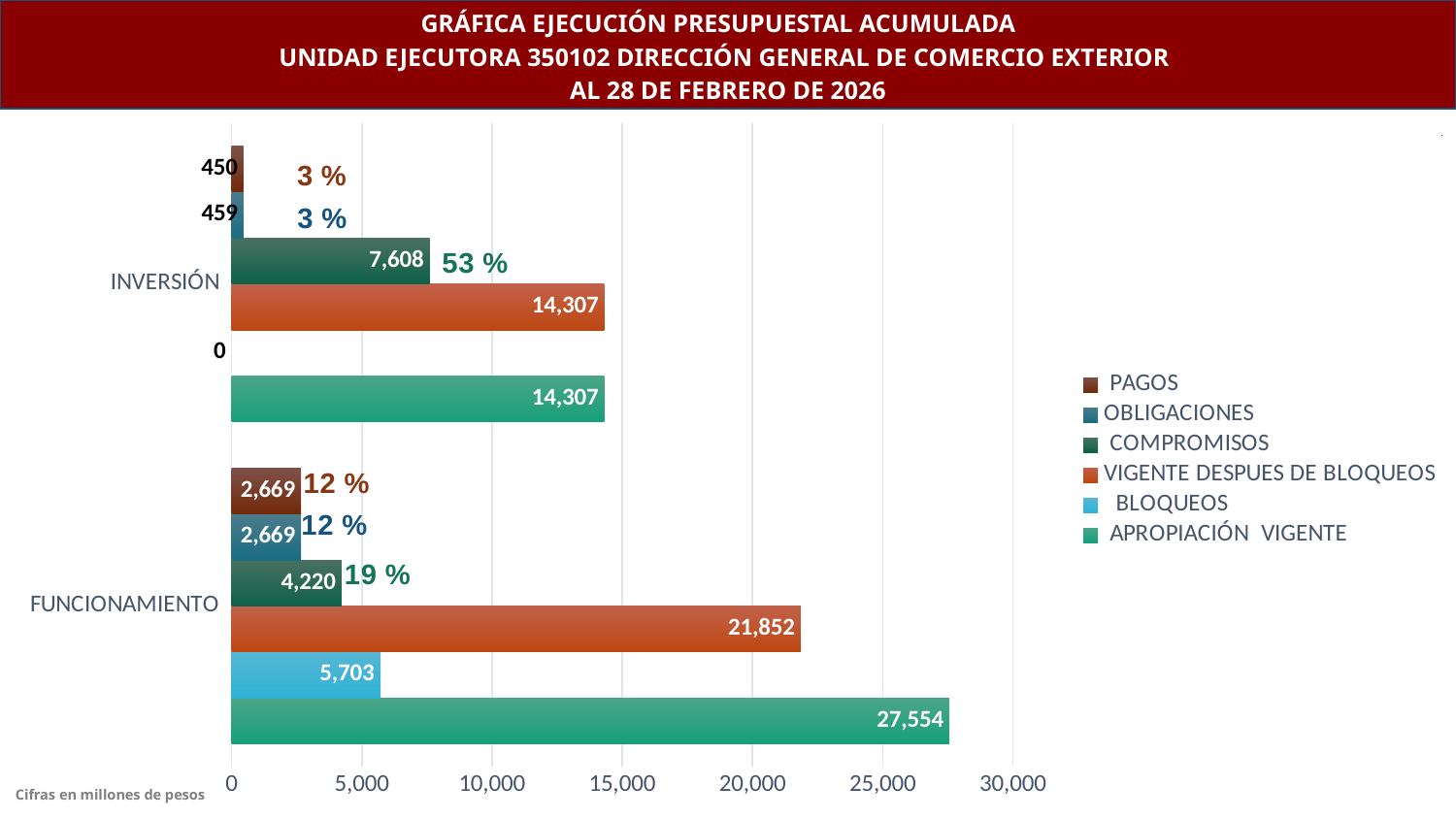
What unit note is printed at the bottom left of the chart? Cifras en millones de pesos What kind of chart is shown on the slide? Bar chart How many series does the legend list? 6 What percentage is shown next to the COMPROMISOS bar for INVERSIÓN? 53 % Which series has the lowest value for INVERSIÓN? BLOQUEOS What is the BLOQUEOS value for FUNCIONAMIENTO? 5,703 What is the difference between APROPIACIÓN VIGENTE and VIGENTE DESPUES DE BLOQUEOS for FUNCIONAMIENTO? 5,702 What is the COMPROMISOS value for INVERSIÓN? 7,608 How many categories are shown on the vertical axis? 2 What is the APROPIACIÓN VIGENTE value for FUNCIONAMIENTO? 27,554 What is the VIGENTE DESPUES DE BLOQUEOS value for INVERSIÓN? 14,307 Which category has the higher COMPROMISOS value, INVERSIÓN or FUNCIONAMIENTO? INVERSIÓN